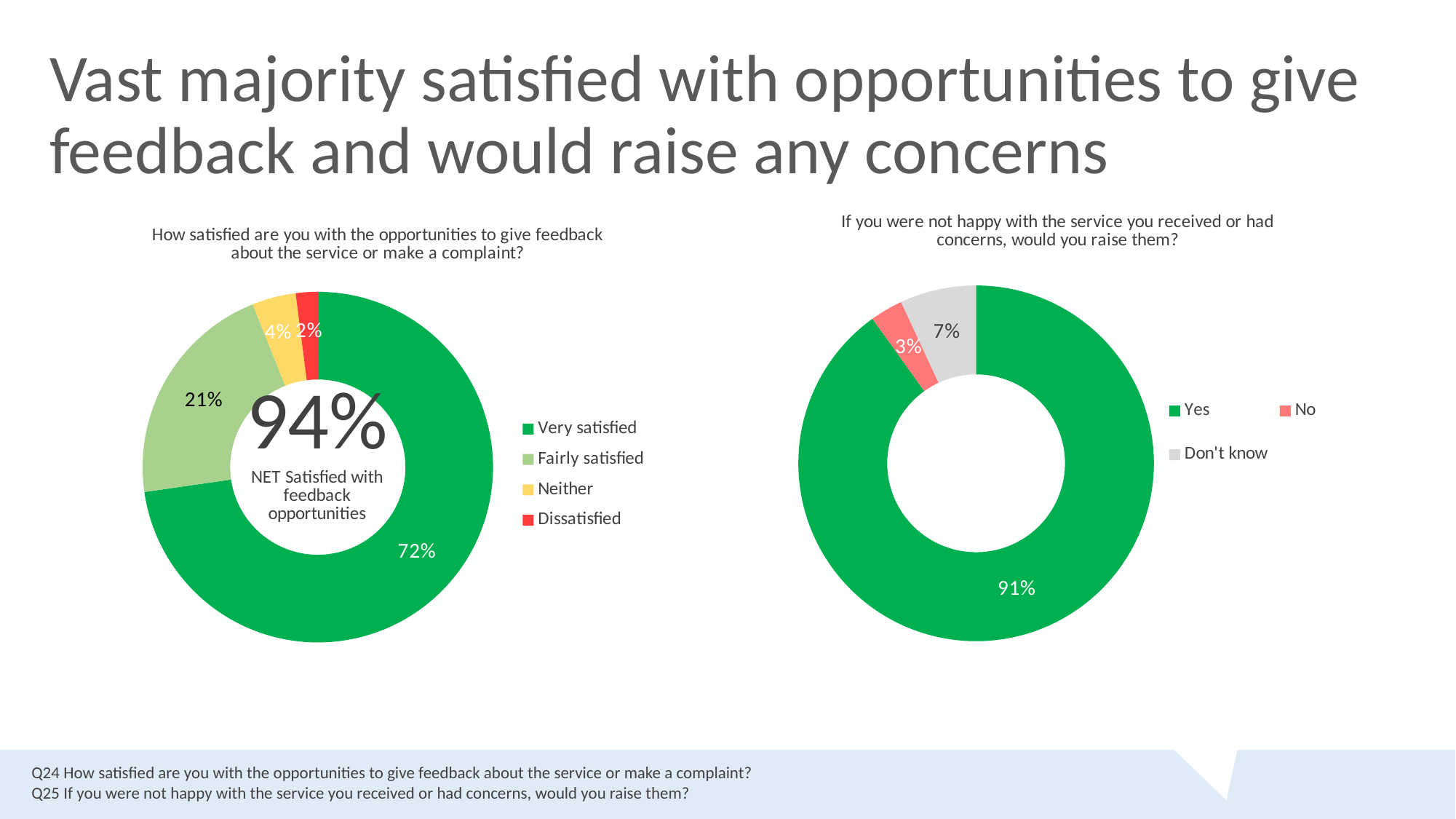
In the right chart (would you raise concerns), which is larger, No or Don't know? Don't know In the left chart (satisfaction with opportunities to give feedback), what NET Satisfied figure is shown in the centre? 94% What type of chart is used on the right side of the slide? Doughnut (pie) chart In the left chart (satisfaction with opportunities to give feedback), what percentage are Very satisfied? 72% In the left chart (satisfaction with opportunities to give feedback), what percentage are Fairly satisfied? 21% In the left chart (satisfaction with opportunities to give feedback), which category has the largest share? Very satisfied In the left chart (satisfaction with opportunities to give feedback), which category has the smallest share? Dissatisfied In the left chart (satisfaction with opportunities to give feedback), what is the difference between the Very satisfied and Fairly satisfied shares? 51 percentage points In the left chart (satisfaction with opportunities to give feedback), what percentage are Dissatisfied? 2% In the left chart (satisfaction with opportunities to give feedback), how many categories does the legend list? 4 In the right chart (would you raise concerns), what percentage answered Don't know? 7% In the right chart (would you raise concerns), what percentage answered Yes? 91%